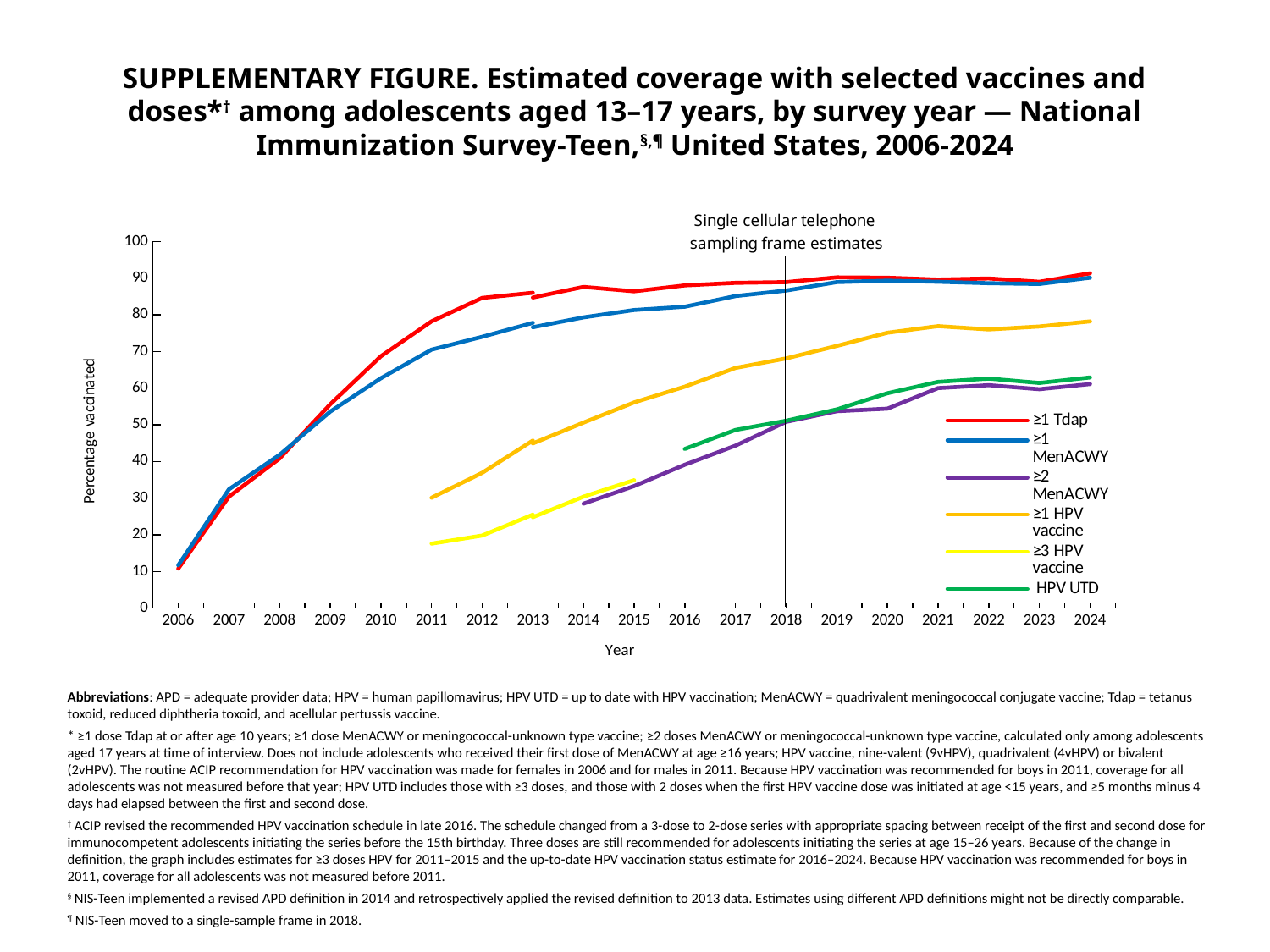
Is the value for ≥1 MenACWY in 2024 greater or less than 80? greater How many series does the legend list? 6 Is the value for ≥1 Tdap in 2006 greater or less than 20? less Which series has the lowest value in 2013? ≥3 HPV vaccine Does the ≥1 HPV vaccine series rise or fall from 2011 to 2024? Rise What kind of chart is shown on the slide? Line chart In 2024, which is larger: ≥1 Tdap or ≥1 HPV vaccine? ≥1 Tdap Is the value for ≥1 HPV vaccine in 2011 greater or less than 40? less How many survey years are shown on the x axis? 19 Which series has the highest value in 2012? ≥1 Tdap In 2018, which is larger: ≥1 MenACWY or ≥1 HPV vaccine? ≥1 MenACWY